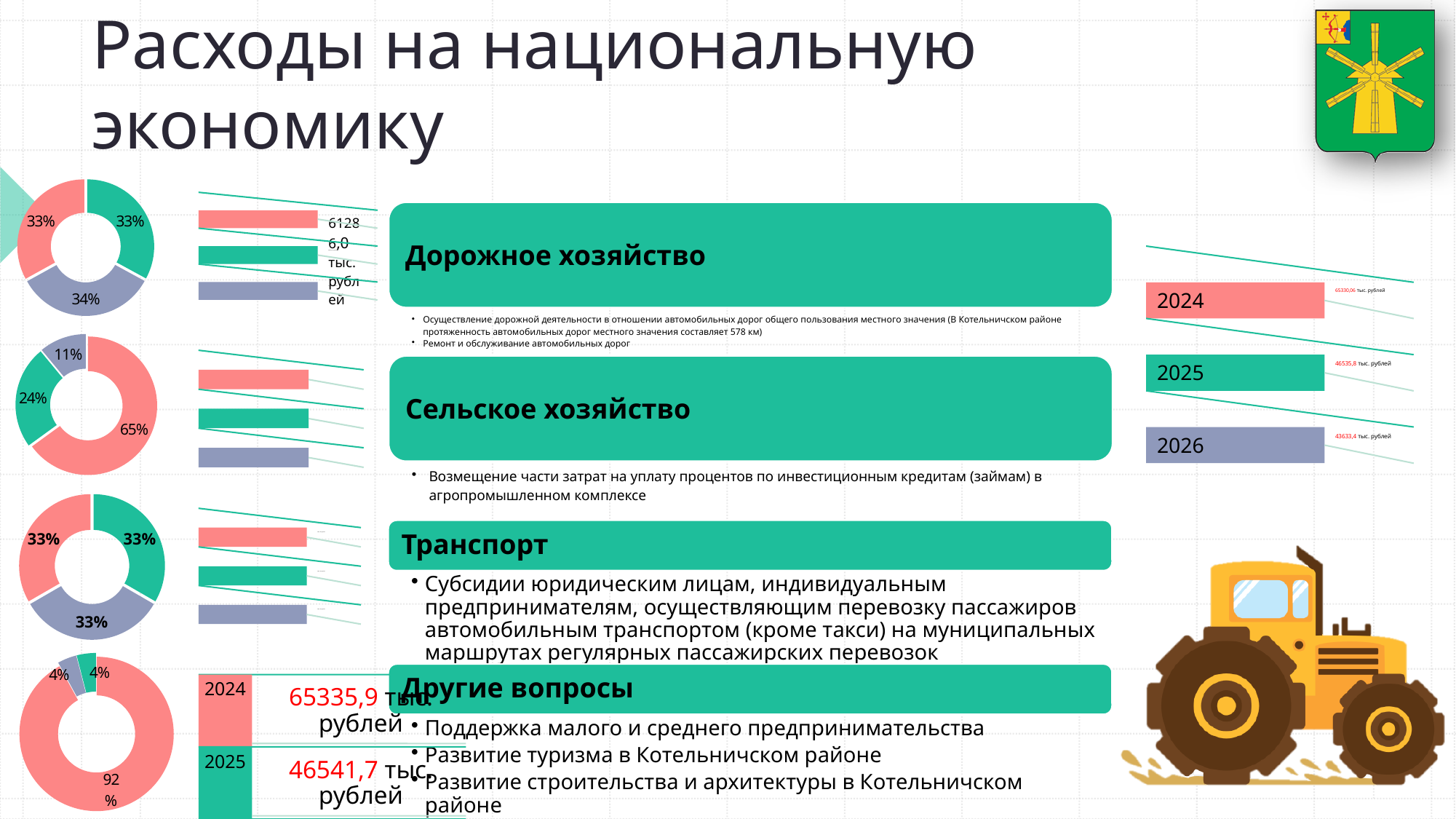
In the bottom donut chart on the left of the slide, what is the largest slice's share? 92% In the bottom donut chart on the left of the slide, what is the difference between the largest slice and one of the 4% slices? 88% In the second donut chart from the top on the left of the slide, what is the smallest slice's share? 11% In the second donut chart from the top on the left of the slide, what is the largest slice's share? 65% In the bar chart at the bottom left of the slide, what is the value for 2024? 65335,9 тыс. рублей In the bar chart at the bottom left of the slide, what is the value for 2025? 46541,7 тыс. рублей In the top donut chart on the left of the slide, what is the share of the purple slice? 34% How many slices does the top donut chart on the left of the slide have? 3 In the second donut chart from the top on the left of the slide, what is the difference between the largest and the second-largest slice? 41% In the bar chart on the right of the slide with years 2024, 2025 and 2026, do the values rise or fall from 2024 to 2026? Fall What kind of chart is the chart at the top left of the slide showing 33%, 33% and 34%? Pie (donut) chart In the bar chart at the bottom left of the slide, what is the difference between the 2024 and 2025 values? 18794,2 тыс. рублей